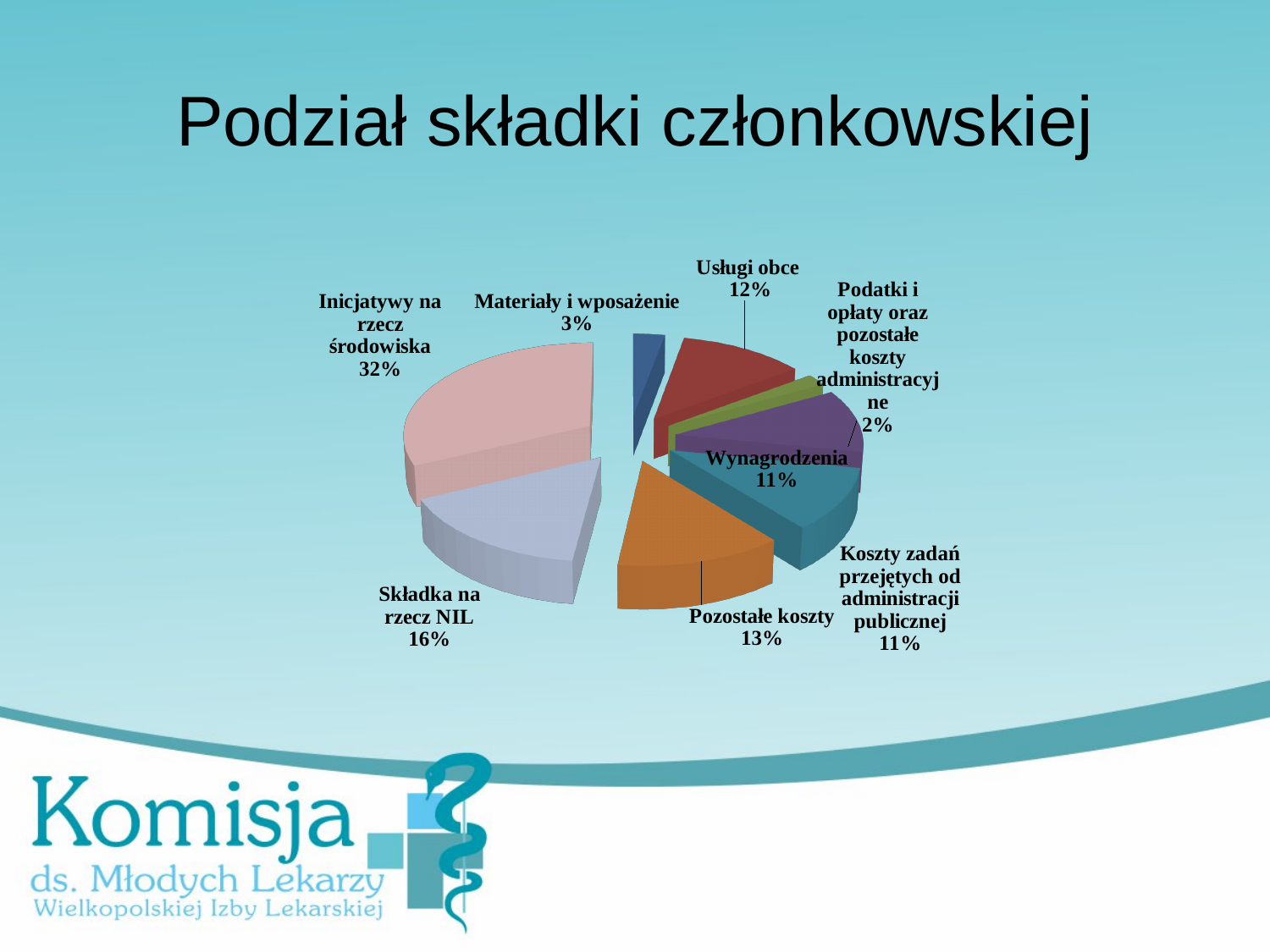
What percentage is shown for "Koszty zadań przejętych od administracji publicznej"? 11% What is the difference in percentage points between "Inicjatywy na rzecz środowiska" and "Składka na rzecz NIL"? 16 What share of the pie is labelled "Inicjatywy na rzecz środowiska"? 32% How many slices does the pie chart have? 8 Which is larger, the share for "Pozostałe koszty" or the share for "Wynagrodzenia"? Pozostałe koszty Which category has the largest share of the pie? Inicjatywy na rzecz środowiska What percentage is shown for "Usługi obce"? 12% What percentage is shown for "Materiały i wposażenie"? 3% What percentage is shown for "Składka na rzecz NIL"? 16% Which category has the smallest share of the pie? Podatki i opłaty oraz pozostałe koszty administracyjne What kind of chart is shown on the slide? pie chart What is the title of the slide's chart? Podział składki członkowskiej